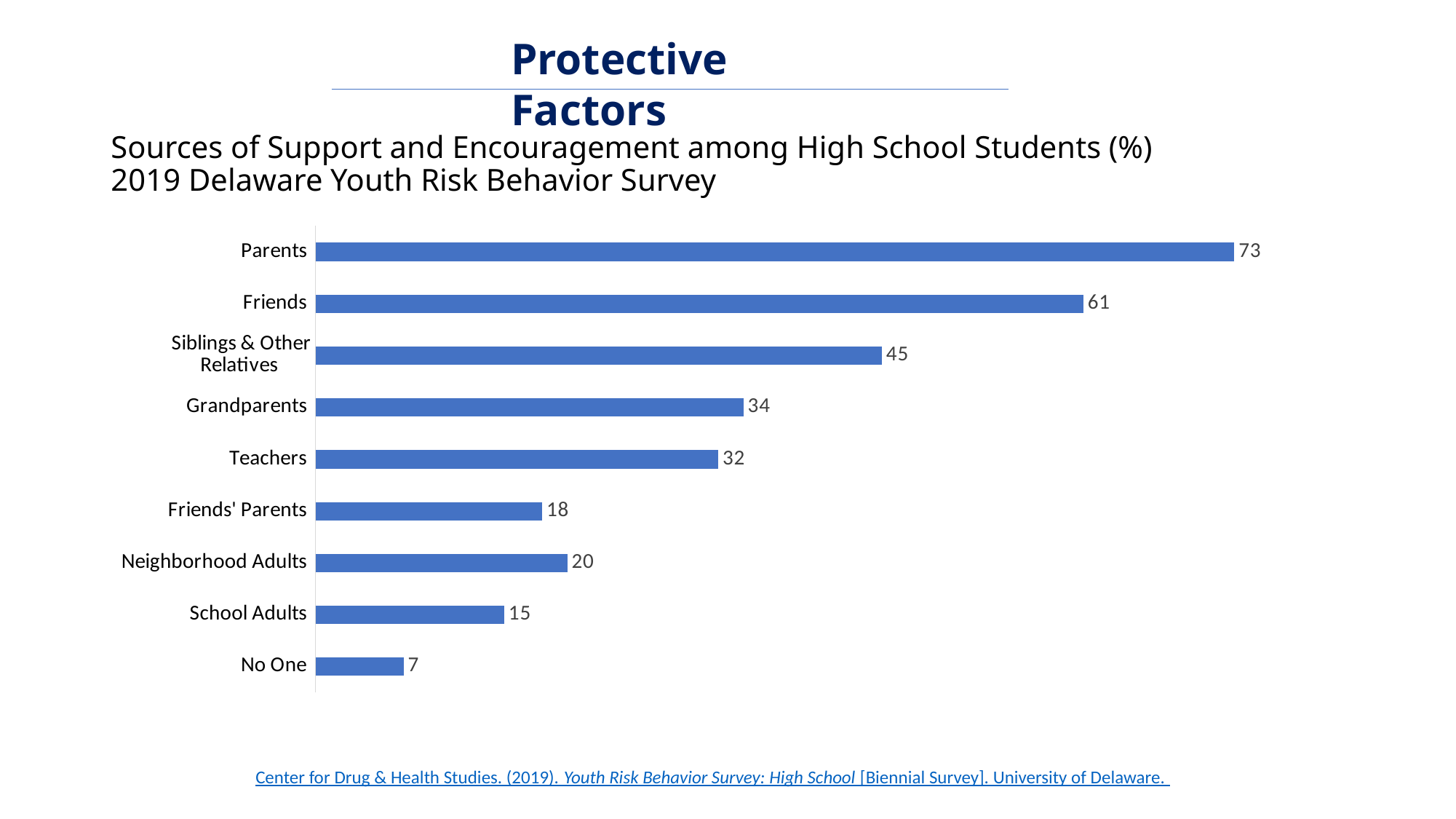
Which is larger, the value for Teachers or the value for School Adults? Teachers Which category has the highest value? Parents What is the difference between the values for Parents and Friends? 12 What is the value for Parents? 73 What kind of chart is shown on the slide? Bar chart How many categories are shown in the chart? 9 Which category has the lowest value? No One What is the value for Neighborhood Adults? 20 Which is larger, the value for Friends' Parents or the value for Neighborhood Adults? Neighborhood Adults What is the value for No One? 7 What is the difference between the values for Grandparents and Teachers? 2 What is the value for Siblings & Other Relatives? 45